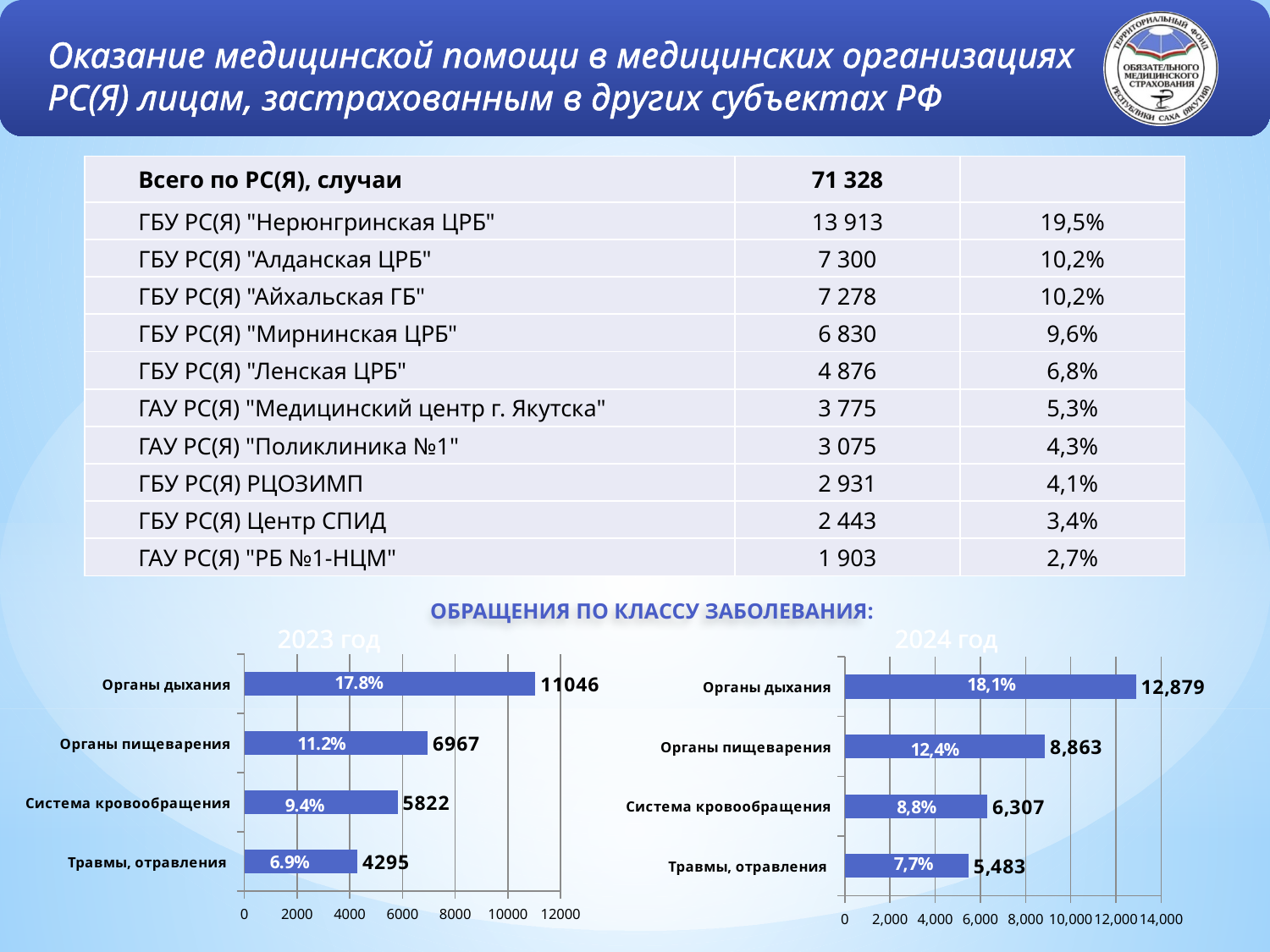
In the 2024 год chart, what is the value for Органы пищеварения? 8,863 In the 2024 год chart, what is the difference between the values for Система кровообращения and Травмы, отравления? 824 In the 2023 год chart, what is the value for Органы дыхания? 11046 In the 2023 год chart, what percentage is shown on the bar for Система кровообращения? 9.4% In the 2024 год chart, which is larger: the value for Органы пищеварения or the value for Система кровообращения? Органы пищеварения In the 2024 год chart, which category has the highest value? Органы дыхания How many categories are shown in the 2023 год chart? 4 What is the heading printed above the two charts? ОБРАЩЕНИЯ ПО КЛАССУ ЗАБОЛЕВАНИЯ: In the 2023 год chart, which category has the lowest value? Травмы, отравления In the 2023 год chart, what is the difference between the values for Органы дыхания and Органы пищеварения? 4079 What kind of chart is the 2024 год chart? bar chart In the 2024 год chart, what percentage is shown on the bar for Травмы, отравления? 7,7%